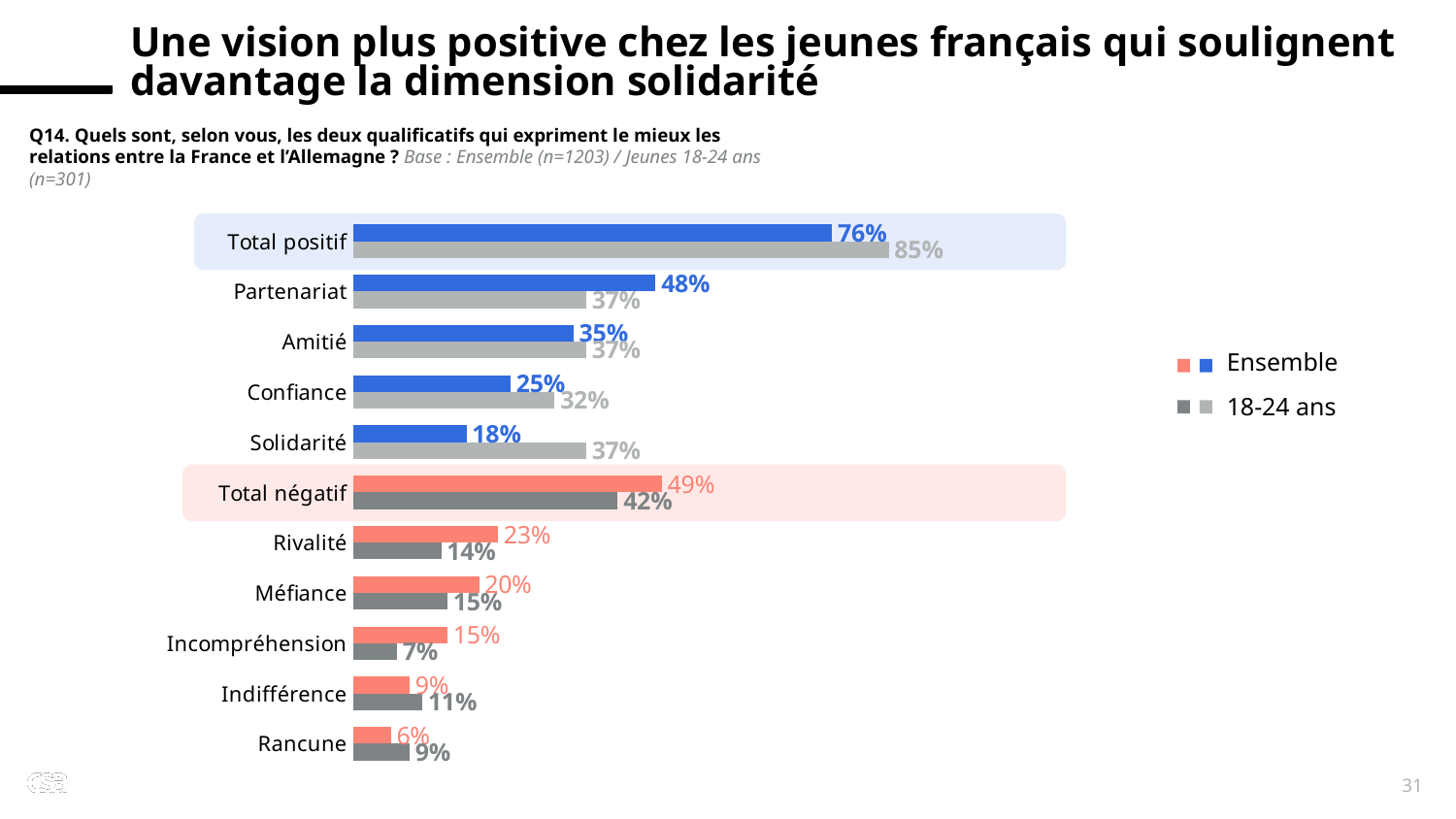
What is the difference between the Ensemble and 18-24 ans values for Rivalité? 9 percentage points For Confiance, which series has the larger value, Ensemble or 18-24 ans? 18-24 ans What is the value for Partenariat for the Ensemble series? 48% How many series does the legend list? 2 How many categories are shown on the chart? 11 Which category has the highest value for the 18-24 ans series? Total positif What is the value for Solidarité for the 18-24 ans series? 37% What kind of chart is shown on the slide? Bar chart Which category has the lowest value for the Ensemble series? Rancune What is the difference between the 18-24 ans and Ensemble values for Solidarité? 19 percentage points What is the value for Total négatif for the Ensemble series? 49% What is the value for Incompréhension for the 18-24 ans series? 7%